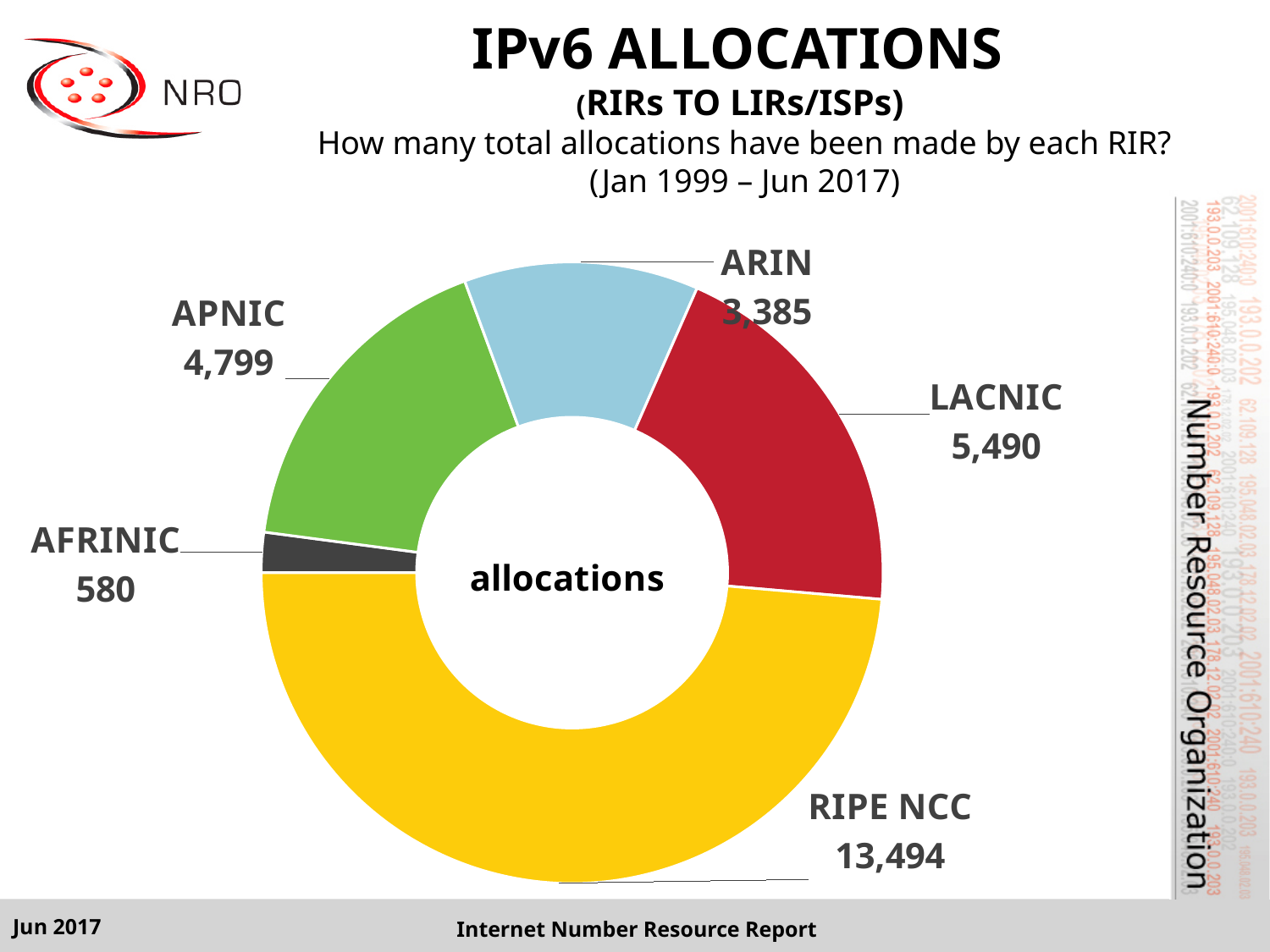
What is the value shown for APNIC? 4,799 What is the value shown for AFRINIC? 580 Which has more IPv6 allocations, APNIC or LACNIC? LACNIC Which RIR has the highest number of IPv6 allocations? RIPE NCC What is the difference between the LACNIC and ARIN allocation values? 2,105 How many RIRs are shown as segments in the chart? 5 How many IPv6 allocations has RIPE NCC made according to the chart? 13,494 What colour is the RIPE NCC segment of the chart? yellow What is the difference between the RIPE NCC and LACNIC allocation values? 8,004 What kind of chart is used on this slide? doughnut chart Which RIR has the lowest number of IPv6 allocations? AFRINIC What is the value shown for LACNIC? 5,490